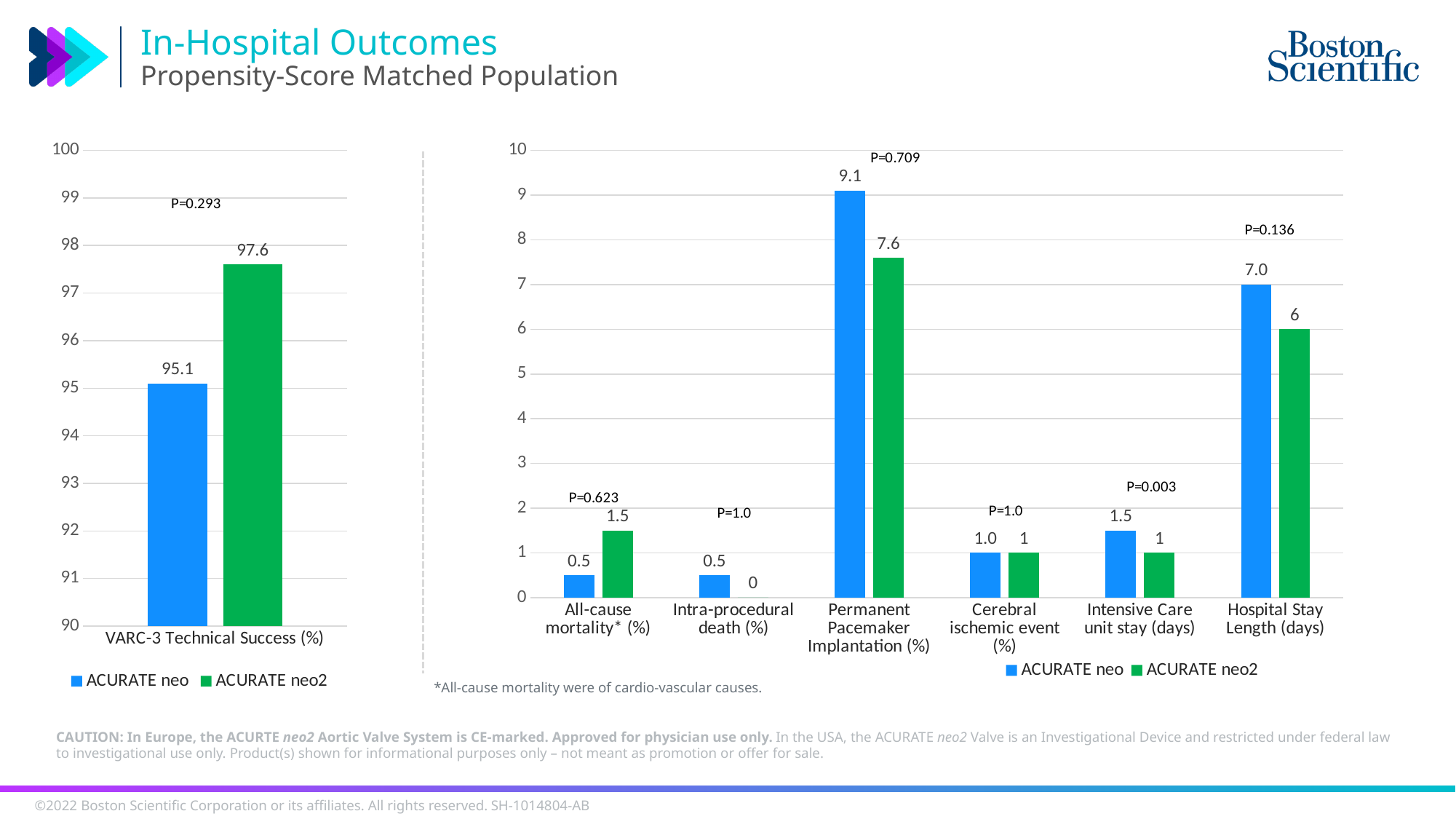
In the right chart, which category has the highest value for ACURATE neo? Permanent Pacemaker Implantation (%) In the right chart, what is the Permanent Pacemaker Implantation (%) value for ACURATE neo? 9.1 In the right chart, what is the Intra-procedural death (%) value for ACURATE neo2? 0 How many categories are shown on the x axis of the right chart? 6 In the right chart, what is the Hospital Stay Length (days) value for ACURATE neo2? 6 How many series does the legend of the right chart list? 2 In the right chart, which is larger for All-cause mortality (%): ACURATE neo or ACURATE neo2? ACURATE neo2 In the left chart, what is the VARC-3 Technical Success (%) value for ACURATE neo2? 97.6 What type of chart is the left chart? Bar chart In the left chart, what is the VARC-3 Technical Success (%) value for ACURATE neo? 95.1 In the right chart, what is the difference between ACURATE neo and ACURATE neo2 for Permanent Pacemaker Implantation (%)? 1.5 In the left chart, what is the difference between the ACURATE neo2 and ACURATE neo values for VARC-3 Technical Success (%)? 2.5